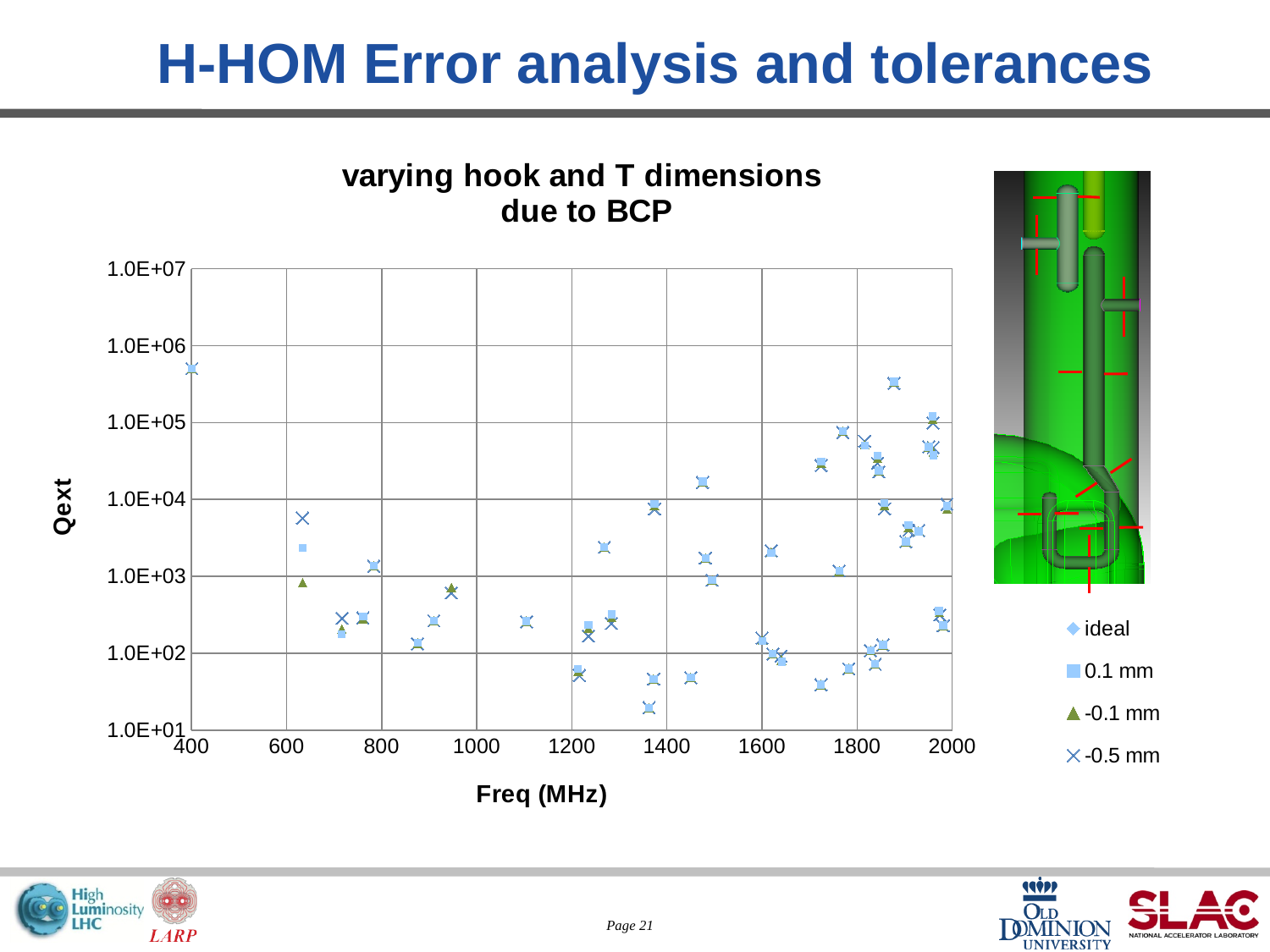
Is the lowest Qext point on the chart (near 1360 MHz) greater or less than 1.0E+02? less What is the title of the chart? varying hook and T dimensions due to BCP Which series are listed in the chart legend? ideal, 0.1 mm, -0.1 mm, -0.5 mm Is the -0.5 mm point near 630 MHz greater or less than 1.0E+03? greater Is the Qext value plotted at 400 MHz greater or less than 1.0E+05? greater Near 630 MHz, which series has the larger Qext value, -0.5 mm or -0.1 mm? -0.5 mm What kind of chart is shown on the slide? scatter chart How many series does the chart legend list? 4